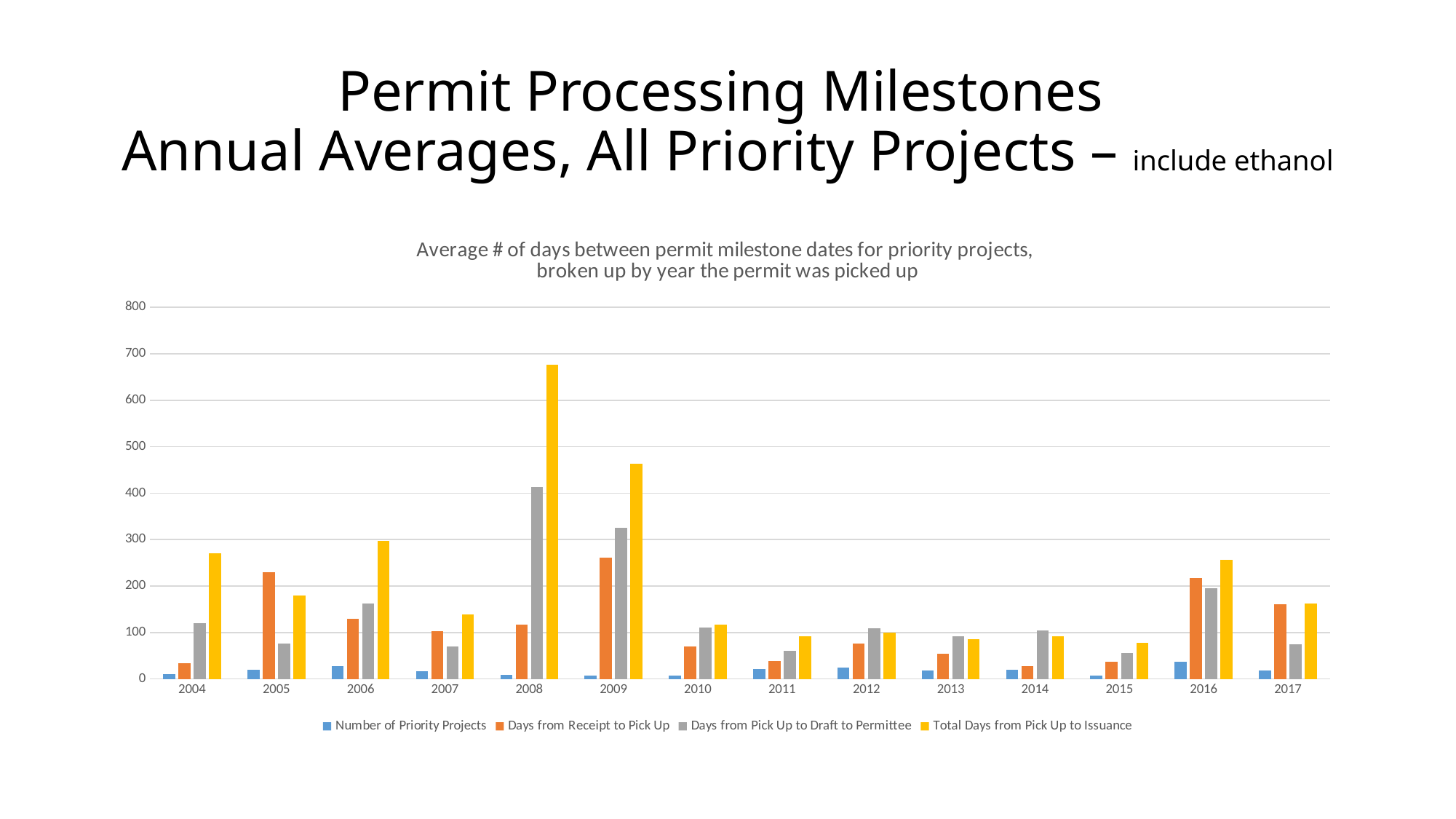
In which year is Total Days from Pick Up to Issuance highest? 2008 What colour represents Total Days from Pick Up to Issuance in the legend? yellow Is the value for Total Days from Pick Up to Issuance in 2015 greater or less than 100? less How many years are shown along the x axis? 14 Is the value for Total Days from Pick Up to Issuance in 2004 greater or less than 200? greater In 2005, which is larger: Days from Receipt to Pick Up or Total Days from Pick Up to Issuance? Days from Receipt to Pick Up Is the value for Total Days from Pick Up to Issuance in 2008 greater or less than 600? greater What kind of chart is shown on the slide? bar chart Which is larger: Days from Pick Up to Draft to Permittee in 2008 or in 2009? 2008 In which year is Days from Receipt to Pick Up highest? 2009 How many series does the legend list? 4